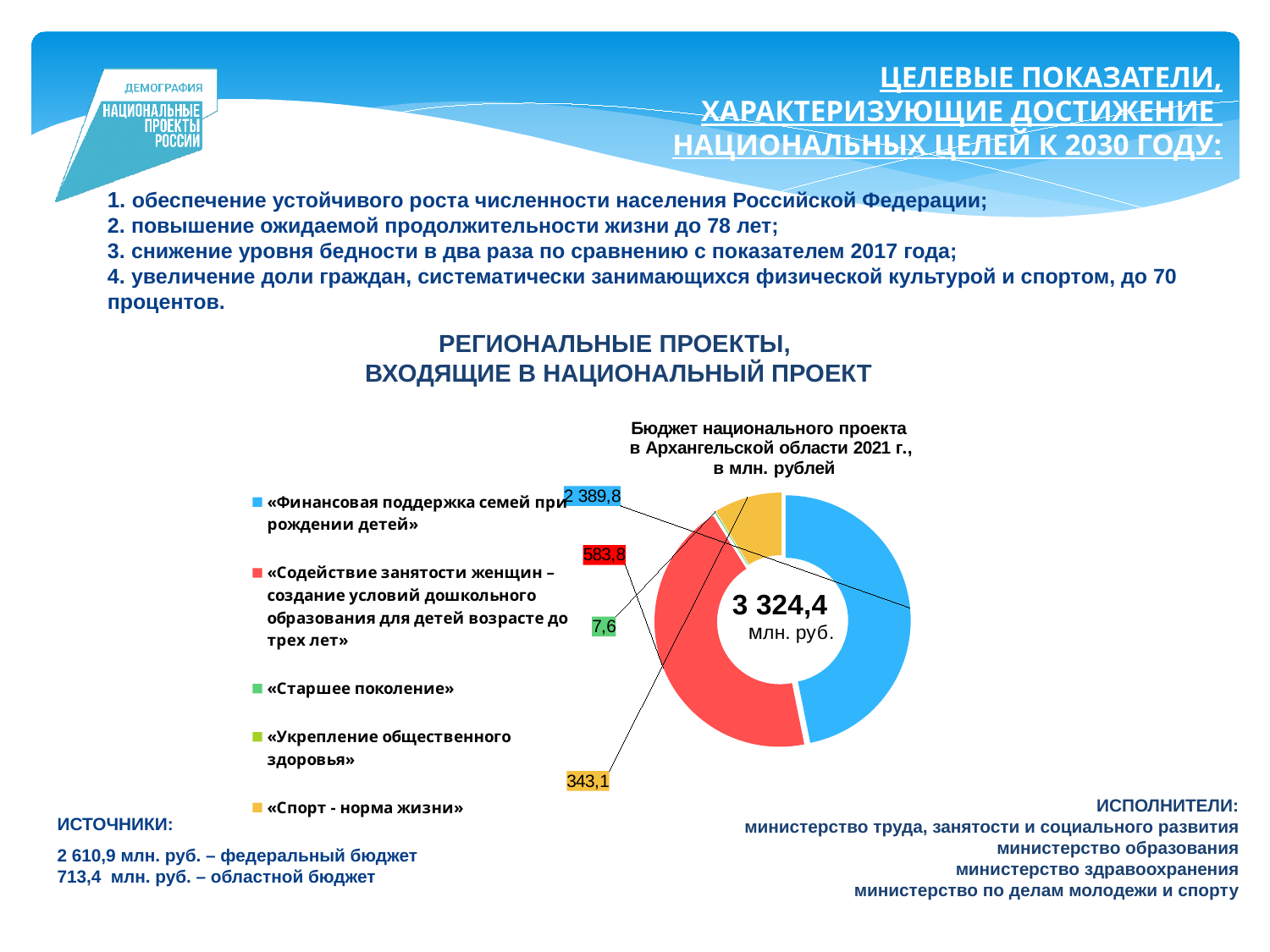
What total value is printed in the centre of the chart? 3 324,4 млн. руб. Which regional project has the largest budget in the chart? «Финансовая поддержка семей при рождении детей» What is the title of the chart? Бюджет национального проекта в Архангельской области 2021 г., в млн. рублей What is the budget value shown for «Старшее поколение»? 7,6 What kind of chart is shown on the slide? Doughnut (pie) chart How many regional projects does the chart legend list? 5 What is the budget value shown for «Содействие занятости женщин – создание условий дошкольного образования для детей возрасте до трех лет»? 583,8 What is the budget value shown for «Финансовая поддержка семей при рождении детей»? 2 389,8 What is the budget value shown for «Спорт - норма жизни»? 343,1 Which has the larger budget: «Содействие занятости женщин» or «Спорт - норма жизни»? «Содействие занятости женщин» What colour represents «Спорт - норма жизни» in the chart? Yellow What is the difference between the budgets of «Финансовая поддержка семей при рождении детей» and «Содействие занятости женщин»? 1 806,0